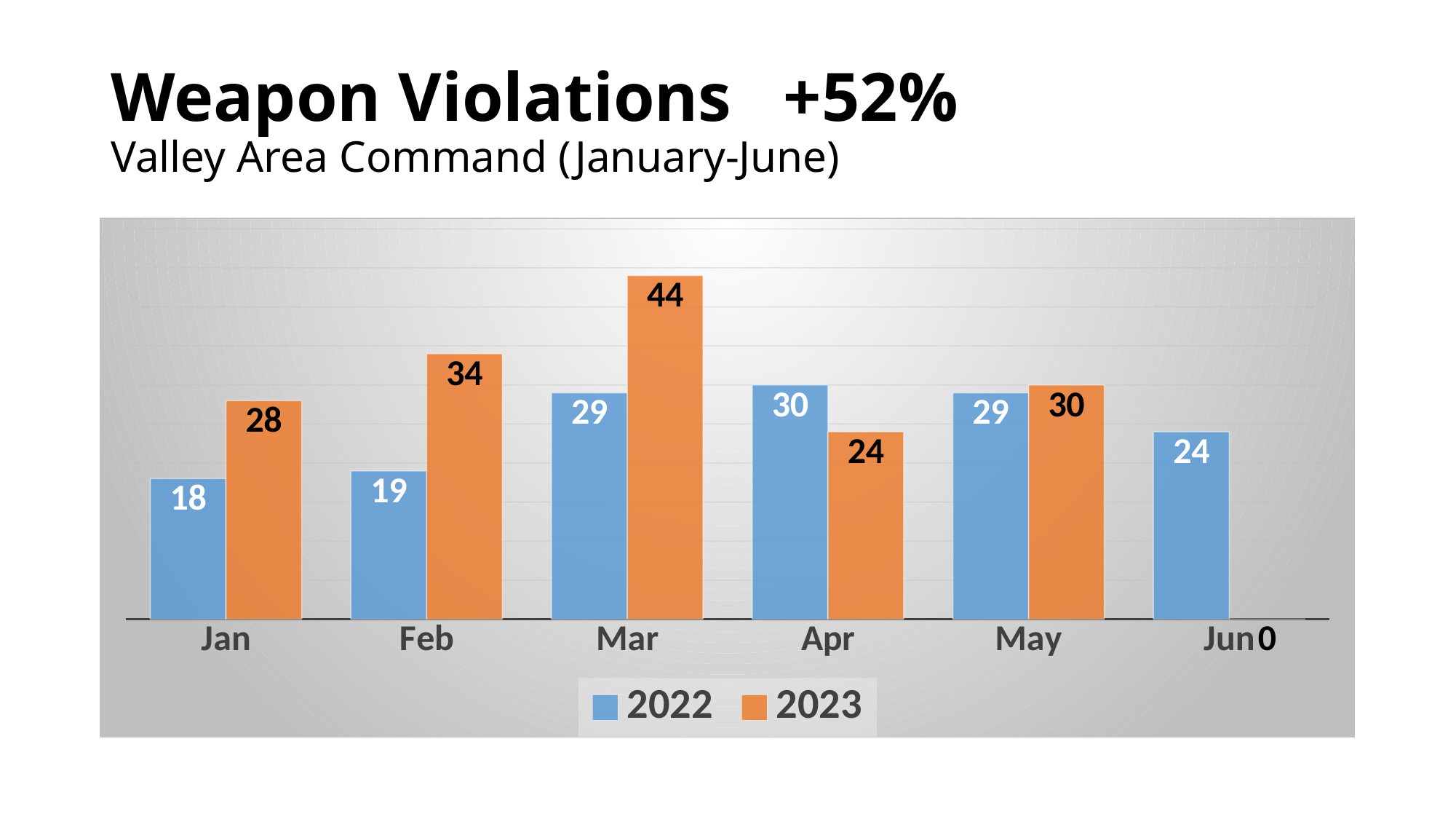
What is the value for 2022 in Jun? 24 How many series does the legend list? 2 How many months are shown on the x axis? 6 What is the value for 2022 in Jan? 18 Which month has the highest value for 2023? Mar In Apr, which series has the larger value, 2022 or 2023? 2022 What percentage change is shown next to the chart title? +52% What is the difference between the 2023 and 2022 values in Feb? 15 What is the value for 2023 in Apr? 24 What is the value for 2023 in Mar? 44 Which month has the lowest value for 2022? Jan What kind of chart is shown on the slide? bar chart